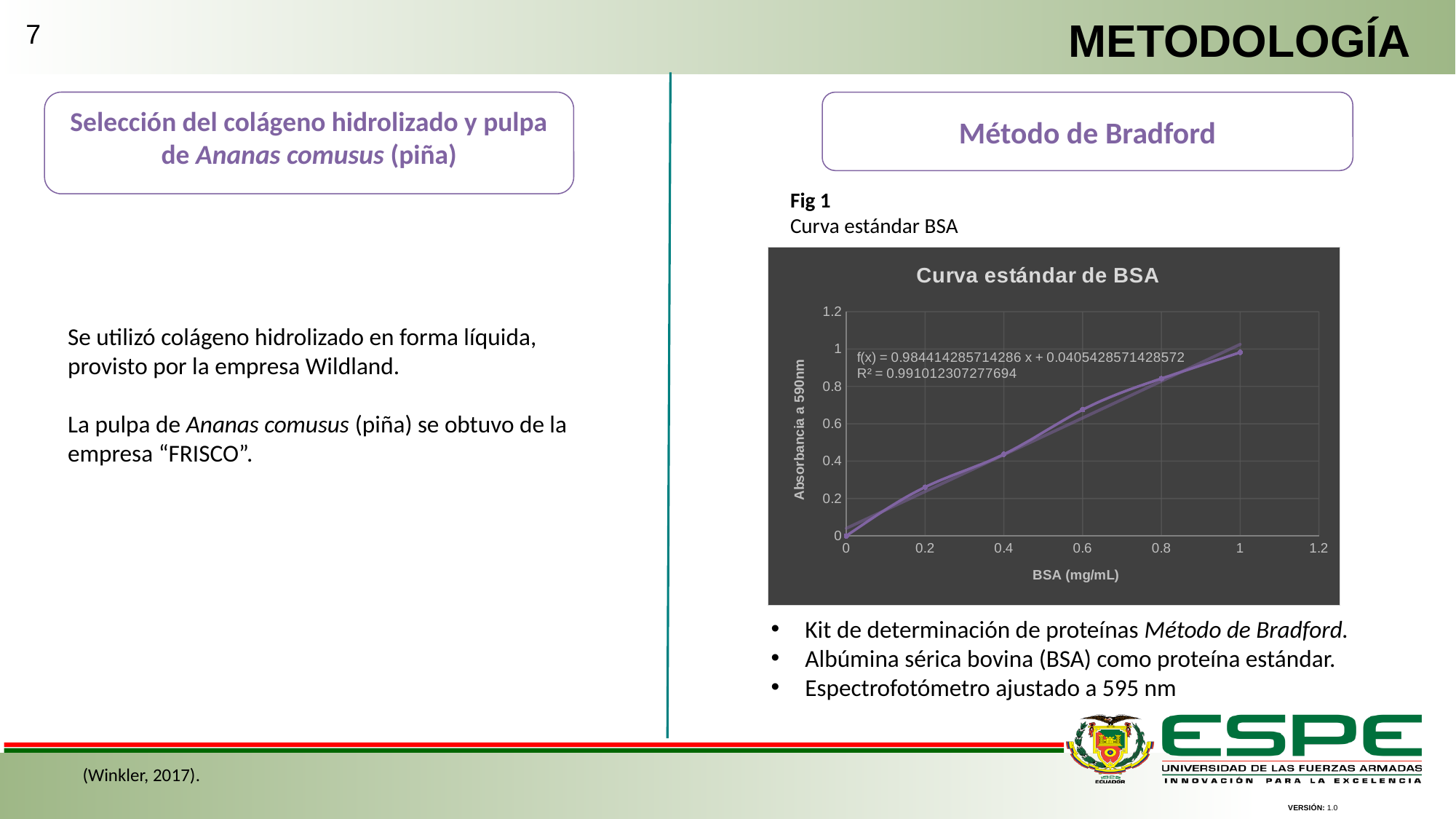
Do the absorbance values rise or fall as BSA concentration increases along the x axis? rise What kind of chart is shown on the slide? line chart What is the trendline equation printed on the chart? f(x) = 0.984414285714286 x + 0.0405428571428572 How many data points are plotted on the curve? 6 Is the absorbance at a BSA concentration of 0.2 mg/mL greater or less than 0.4? less What R² value is printed on the chart? 0.991012307277694 Which has the larger absorbance: BSA at 0.4 mg/mL or BSA at 0.8 mg/mL? 0.8 mg/mL At which BSA concentration is the absorbance lowest? 0 At which BSA concentration is the absorbance highest? 1 What is the label of the x axis? BSA (mg/mL) What is the title of the chart? Curva estándar de BSA Is the absorbance at a BSA concentration of 0.6 mg/mL greater or less than 0.6? greater